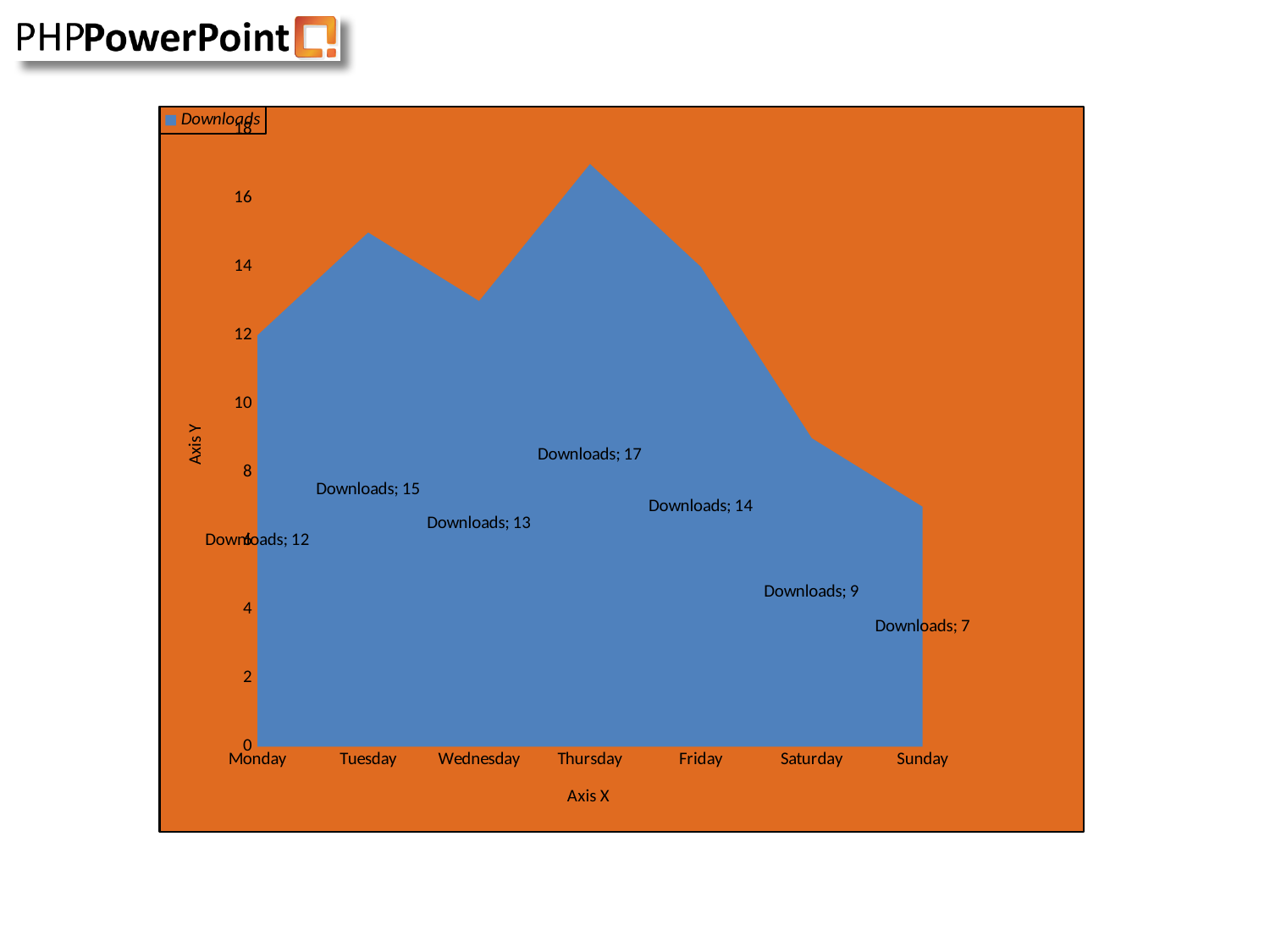
Which day has the lowest Downloads value? Sunday How many days are shown on the x axis? 7 What is the difference between the Downloads values for Thursday and Sunday? 10 What is the title of the vertical axis? Axis Y What is the Downloads value for Tuesday? 15 What is the Downloads value for Thursday? 17 Is the Downloads value for Saturday greater or less than 10? less What kind of chart is shown on the slide? area chart Which day has the highest Downloads value? Thursday What is the Downloads value for Sunday? 7 How many series does the legend list? 1 Which has a larger Downloads value, Tuesday or Friday? Tuesday